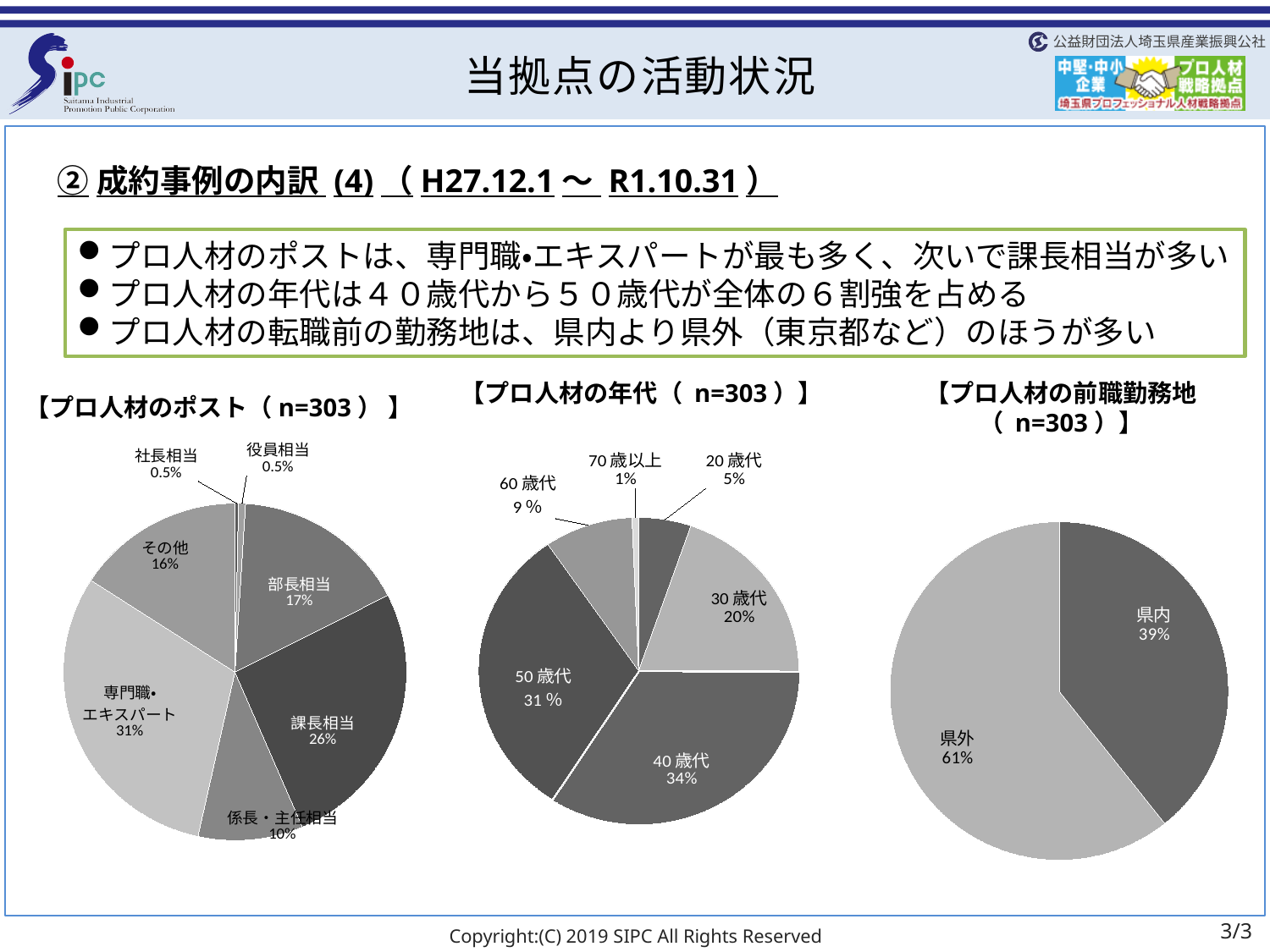
In the 【プロ人材の年代（n=303）】 chart, how many age groups are shown? 6 In the 【プロ人材のポスト（n=303）】 chart, which category has the largest share? 専門職・エキスパート In the 【プロ人材の年代（n=303）】 chart, which is larger, 30歳代 or 60歳代? 30歳代 In the 【プロ人材の年代（n=303）】 chart, what is the combined share of 40歳代 and 50歳代? 65% In the 【プロ人材のポスト（n=303）】 chart, what share is 課長相当? 26% In the 【プロ人材の前職勤務地（n=303）】 chart, what share is 県外? 61% In the 【プロ人材のポスト（n=303）】 chart, how many categories are shown? 7 In the 【プロ人材の前職勤務地（n=303）】 chart, what is the difference between 県外 and 県内? 22% In the 【プロ人材の年代（n=303）】 chart, what share is 50歳代? 31% What type of chart is used for 【プロ人材の前職勤務地（n=303）】? Pie chart In the 【プロ人材のポスト（n=303）】 chart, what is the difference between 部長相当 and 係長・主任相当? 7% In the 【プロ人材の年代（n=303）】 chart, which age group has the smallest share? 70歳以上